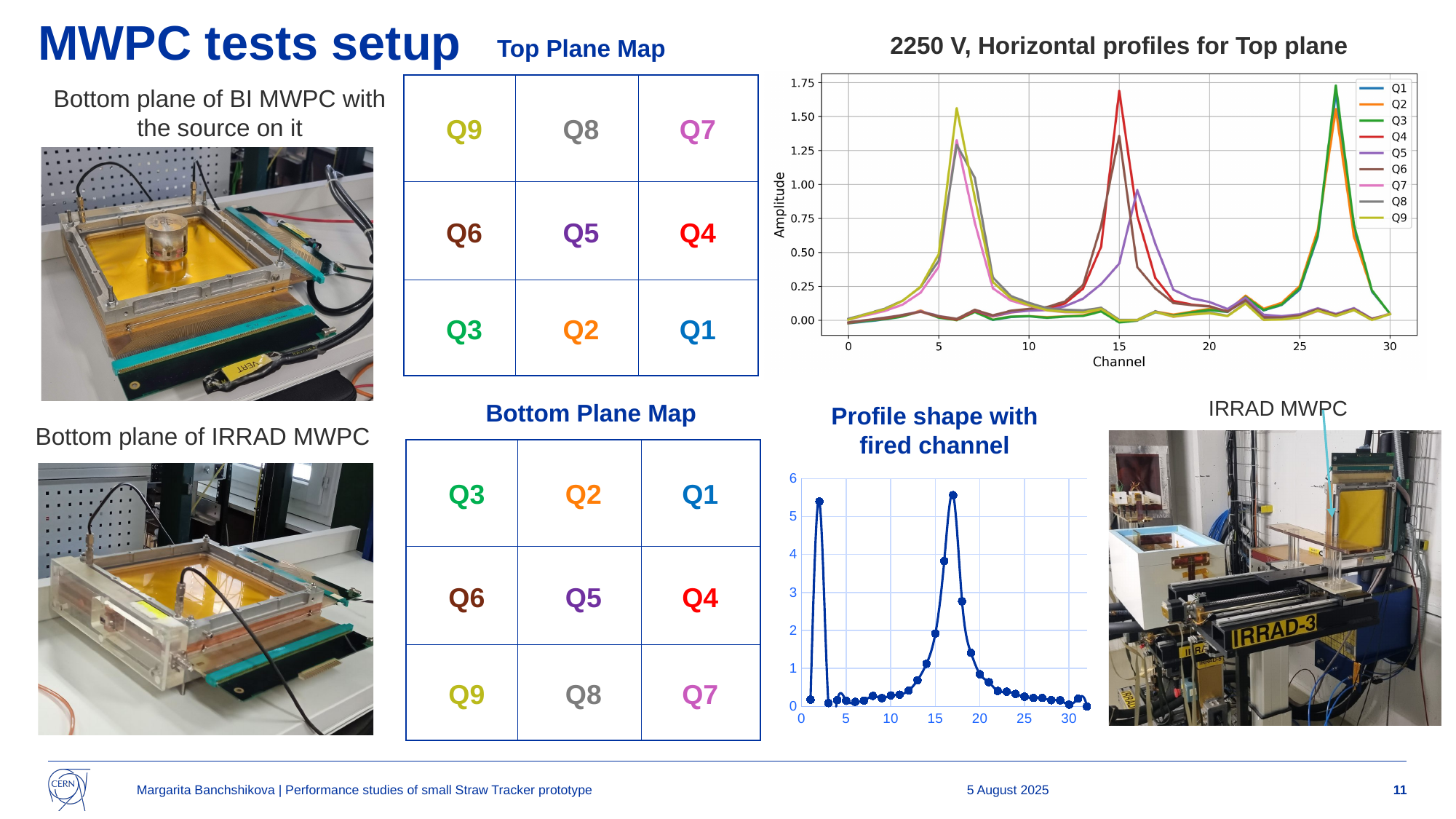
In the '2250 V, Horizontal profiles for Top plane' chart, which has the higher peak amplitude, Q4 or Q5? Q4 What kind of chart is the 'Profile shape with fired channel' chart? line chart In the '2250 V, Horizontal profiles for Top plane' chart, what is the label of the y axis? Amplitude What kind of chart is the '2250 V, Horizontal profiles for Top plane' chart? line chart In the 'Profile shape with fired channel' chart, is the value at channel 10 greater or less than 1? less How many series does the legend of the '2250 V, Horizontal profiles for Top plane' chart list? 9 In the 'Profile shape with fired channel' chart, is the highest value near channel 17 greater or less than 5? greater In the '2250 V, Horizontal profiles for Top plane' chart, what is the label of the x axis? Channel In the '2250 V, Horizontal profiles for Top plane' chart, is the peak amplitude of Q3 greater or less than 1.50? greater In the 'Profile shape with fired channel' chart, do the values rise or fall from channel 17 to channel 30? fall